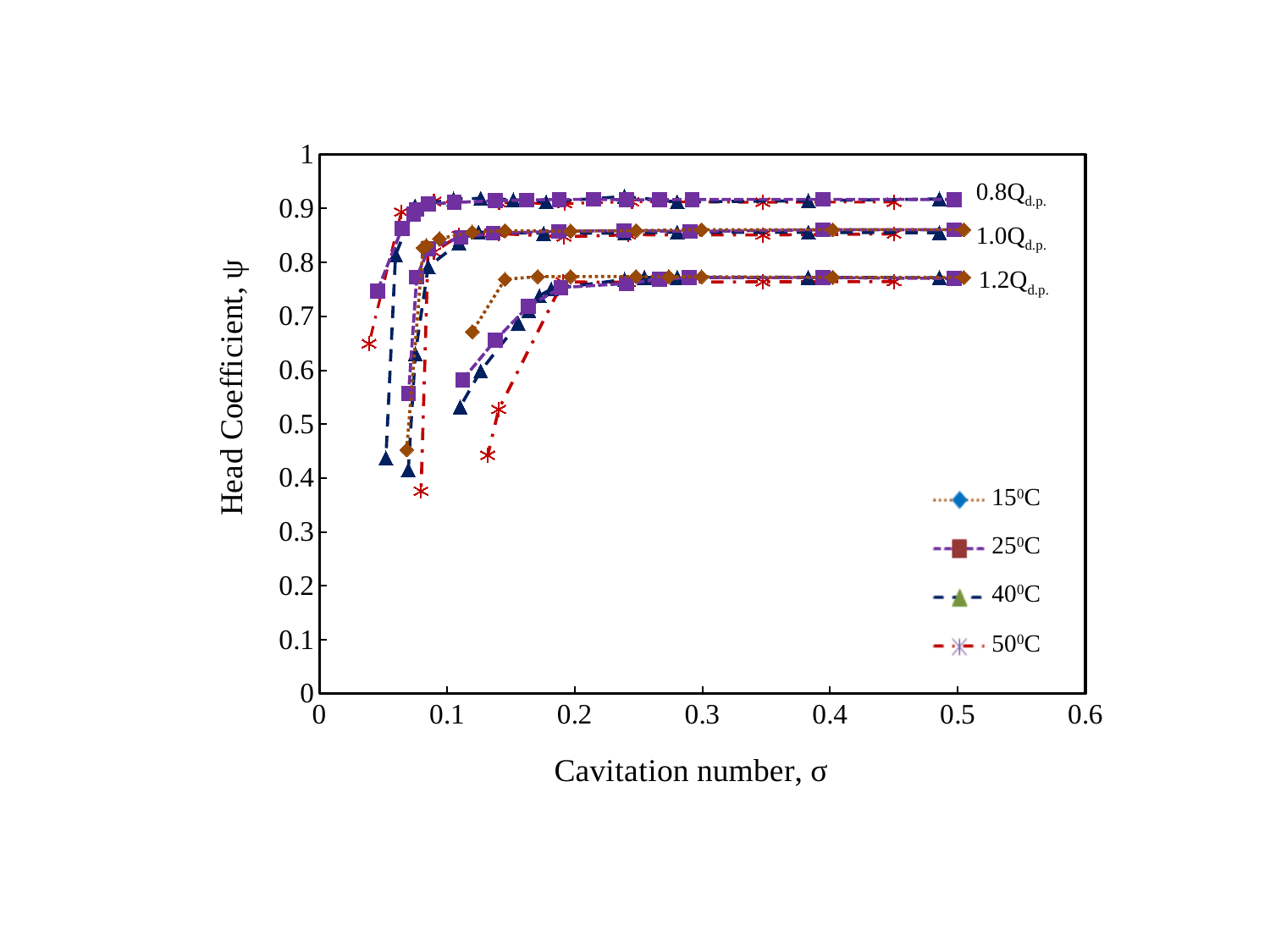
Is the plateau head coefficient for the 1.2Q d.p. group higher or lower than that of the 0.8Q d.p. group? lower Which flow-rate group (0.8Q, 1.0Q or 1.2Q d.p.) has the highest plateau head coefficient? 0.8Q d.p. As the cavitation number increases from its lowest values, does the head coefficient rise or fall before levelling off? rise Is the plateau head coefficient for the 1.2Q d.p. group greater or less than 0.8? less Which flow-rate group (0.8Q, 1.0Q or 1.2Q d.p.) has the lowest plateau head coefficient? 1.2Q d.p. Is the lowest head coefficient of the 50°C series in the 1.2Q d.p. group greater or less than 0.5? less How many series does the legend list? 4 What is the label of the y axis? Head Coefficient, ψ Is the plateau head coefficient for the 1.0Q d.p. group greater or less than 0.8? greater What kind of chart is shown on the slide? line chart What are the four temperatures listed in the legend? 15°C, 25°C, 40°C, 50°C